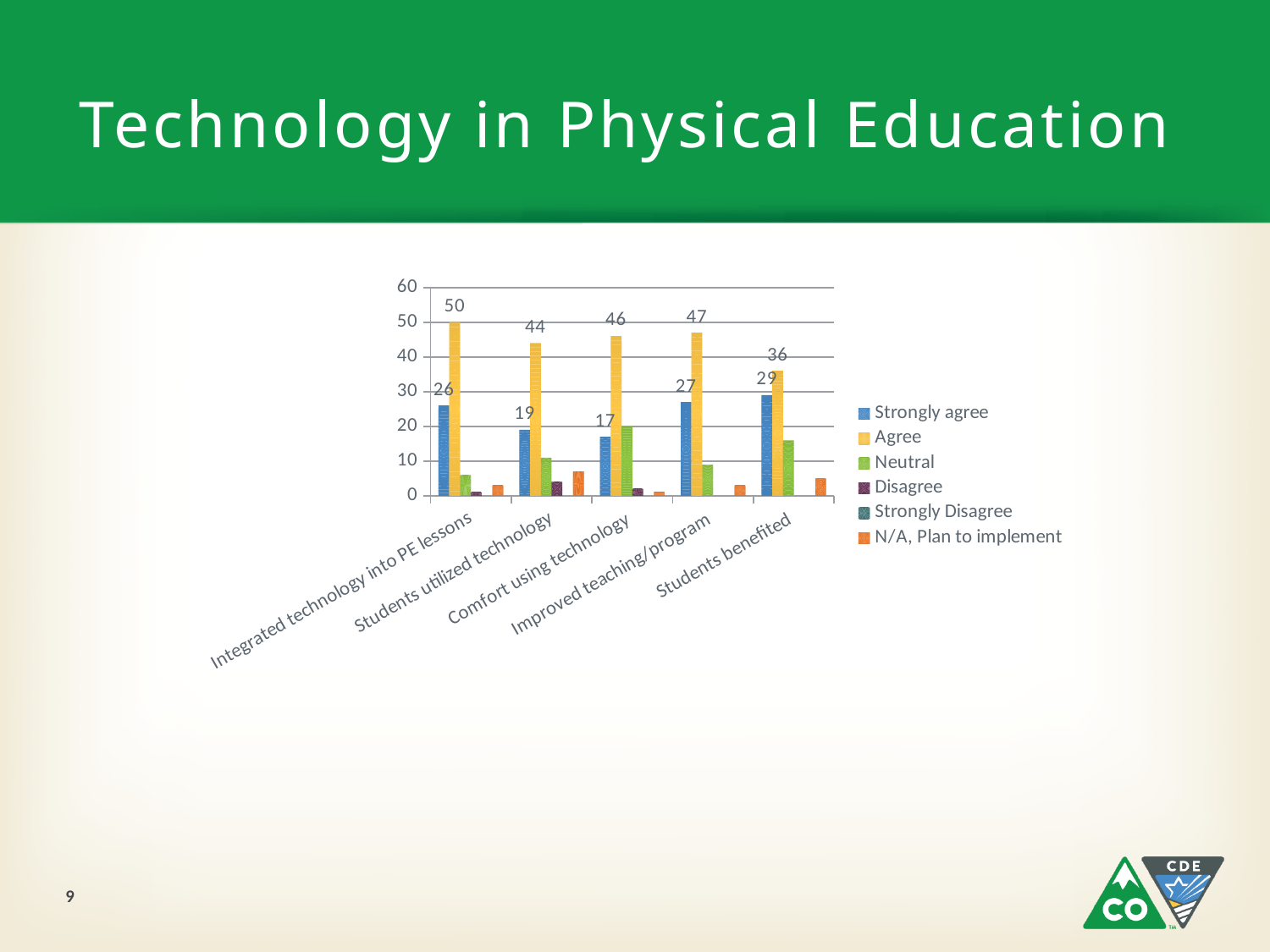
Which category has the lowest Strongly agree value? Comfort using technology How many categories are shown on the x axis? 5 Which category has the highest Agree value? Integrated technology into PE lessons How many series does the legend list? 6 Which is larger for Students utilized technology: the Strongly agree value or the Agree value? Agree What is the difference between the Agree and Strongly agree values for Improved teaching/program? 20 Is the Neutral value for Comfort using technology greater or less than 10? greater Which legend entry is shown in orange? N/A, Plan to implement What is the value for Agree in the Integrated technology into PE lessons category? 50 What is the value for Strongly agree in the Comfort using technology category? 17 What kind of chart is shown on the slide? Bar chart What is the value for Agree in the Students benefited category? 36